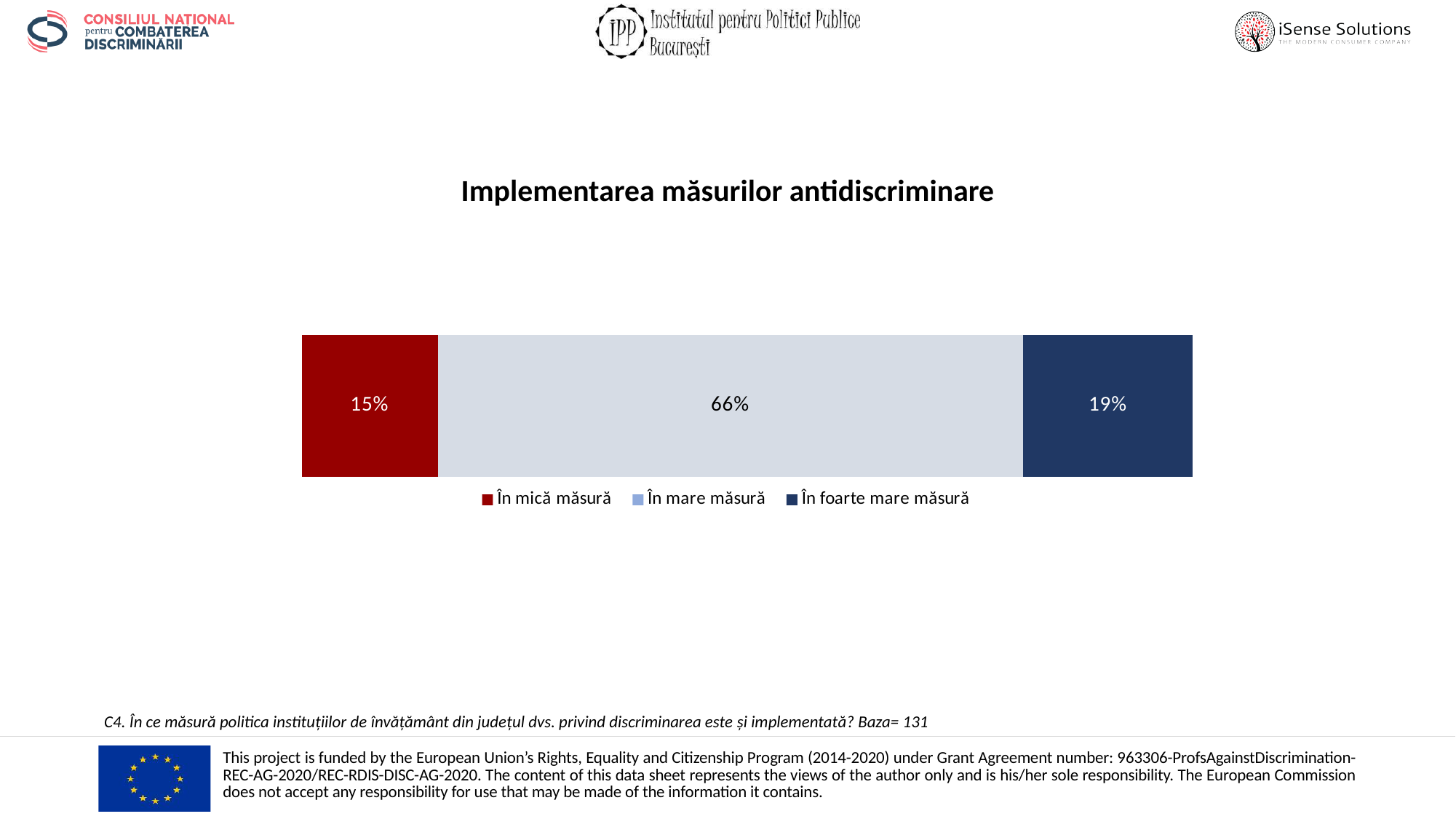
What is the value for "În mare măsură"? 66% What is the value for "În foarte mare măsură"? 19% Which is larger, the value for "În mică măsură" or the value for "În foarte mare măsură"? În foarte mare măsură What is the value for "În mică măsură"? 15% Which series has the lowest value? În mică măsură What is the total of the stacked bar? 100% What is the difference between the values for "În mare măsură" and "În foarte mare măsură"? 47% What kind of chart is shown on the slide? Stacked bar chart What is the title of the chart? Implementarea măsurilor antidiscriminare Which series has the highest value? În mare măsură How many series does the legend list? 3 What is the difference between the values for "În foarte mare măsură" and "În mică măsură"? 4%